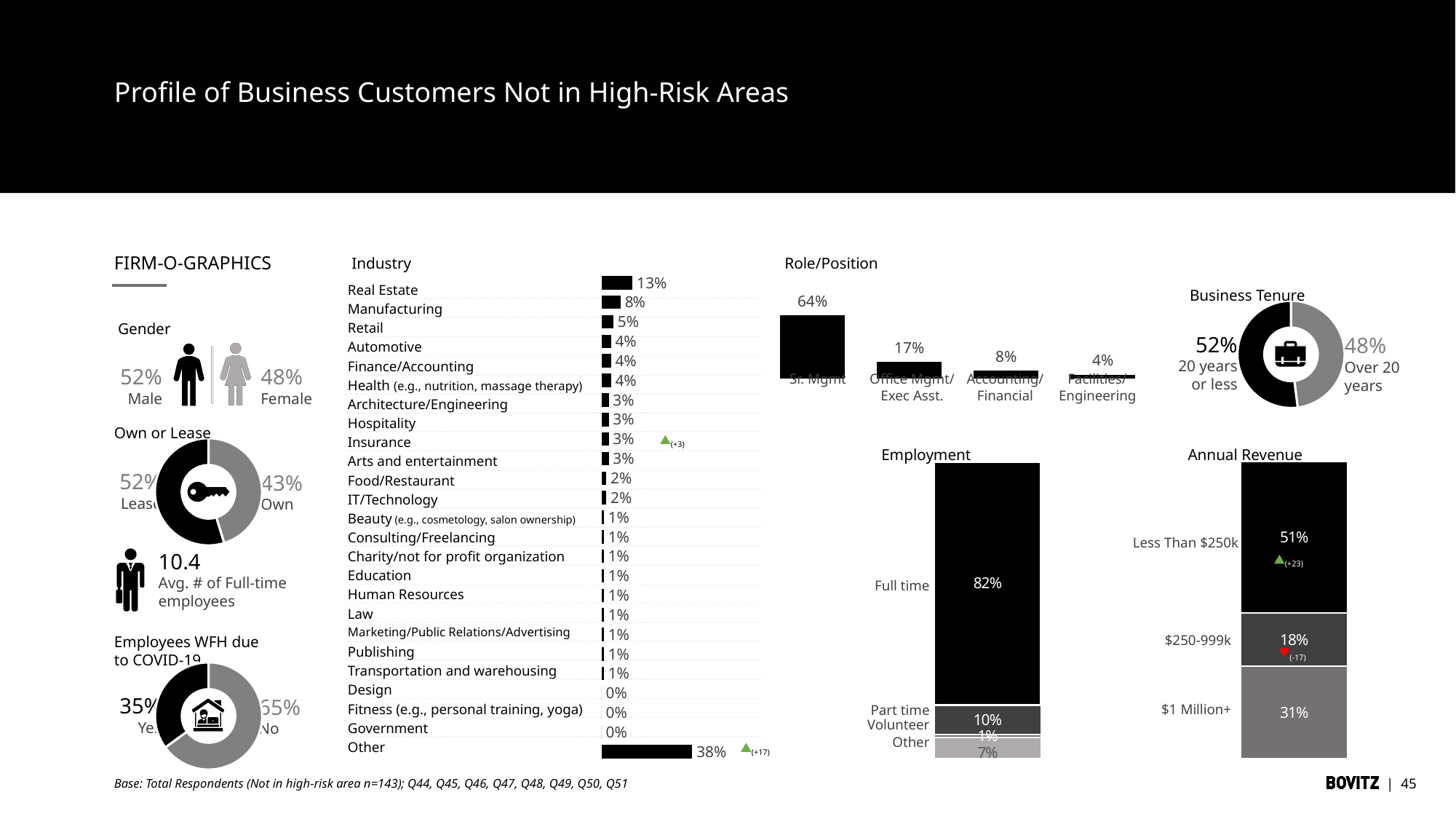
What kind of chart is used for Industry? Bar chart In the Annual Revenue stacked bar, which segment is larger: $250-999k or $1 Million+? $1 Million+ In the Annual Revenue stacked bar, what is the total of the three segments? 100% In the Role/Position chart, which category has the lowest percentage? Facilities/Engineering How many categories are shown in the Role/Position chart? 4 In the Industry chart, what is the difference between Real Estate and Retail? 8% In the Business Tenure donut chart, what share is shown for Over 20 years? 48% In the Industry chart, which category has the highest percentage? Other In the Employment stacked bar, what percentage is shown for Full time? 82% In the Role/Position chart, what percentage is shown for Sr. Mgmt? 64% In the Industry chart, what percentage is shown for Manufacturing? 8% In the Industry chart, what percentage is shown for Real Estate? 13%